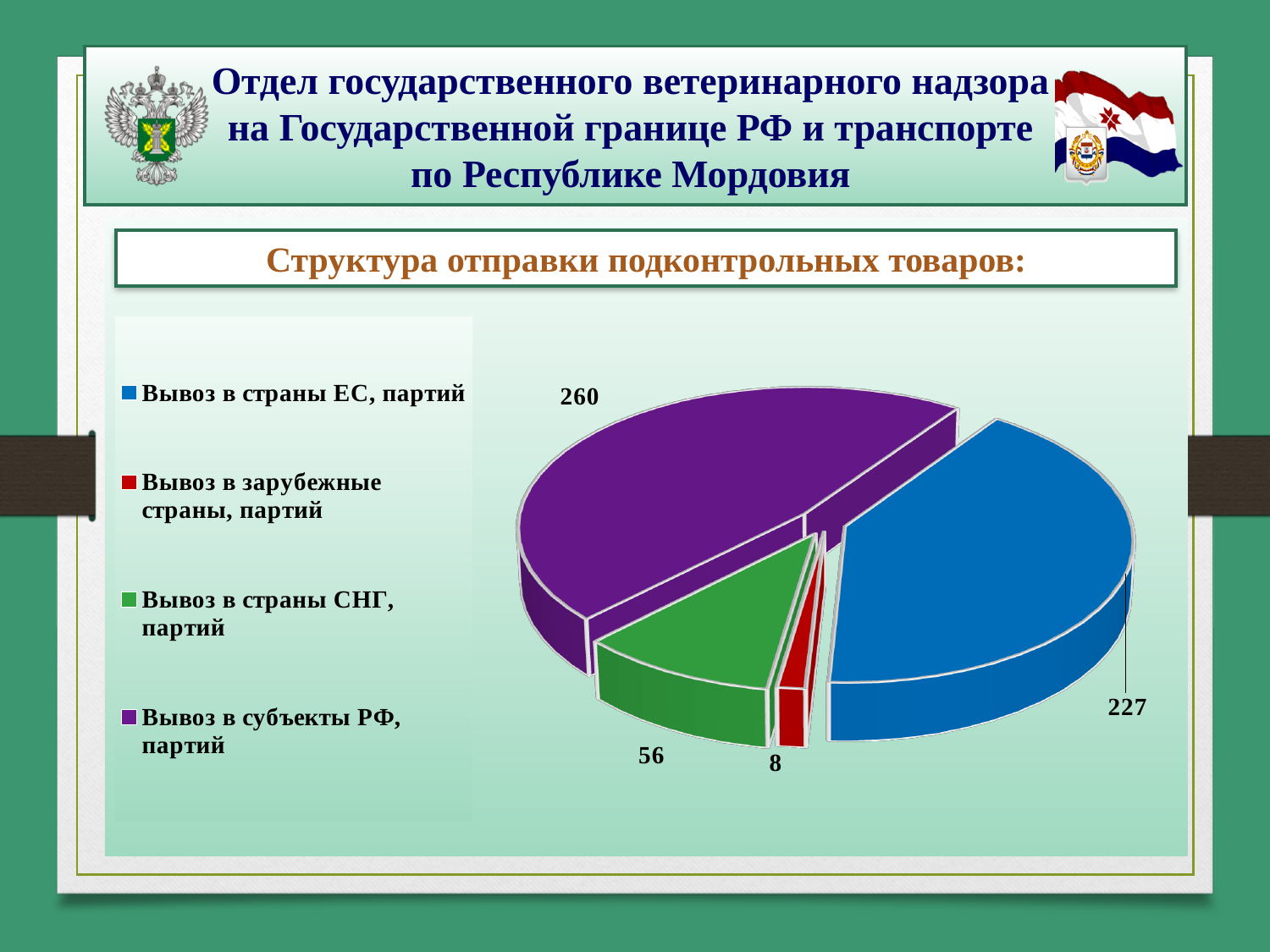
How many entries does the legend list? 4 What is the difference between the values for "Вывоз в субъекты РФ, партий" and "Вывоз в страны ЕС, партий"? 33 What is the title shown above the chart? Структура отправки подконтрольных товаров: Which category has the largest slice? Вывоз в субъекты РФ, партий Which is larger: the value for "Вывоз в страны СНГ, партий" or for "Вывоз в зарубежные страны, партий"? Вывоз в страны СНГ, партий What is the value for "Вывоз в страны СНГ, партий"? 56 What kind of chart is shown on the slide? Pie chart What is the value for "Вывоз в зарубежные страны, партий"? 8 What is the value for "Вывоз в страны ЕС, партий"? 227 How many slices does the pie chart have? 4 Which category has the smallest slice? Вывоз в зарубежные страны, партий What is the value for "Вывоз в субъекты РФ, партий"? 260